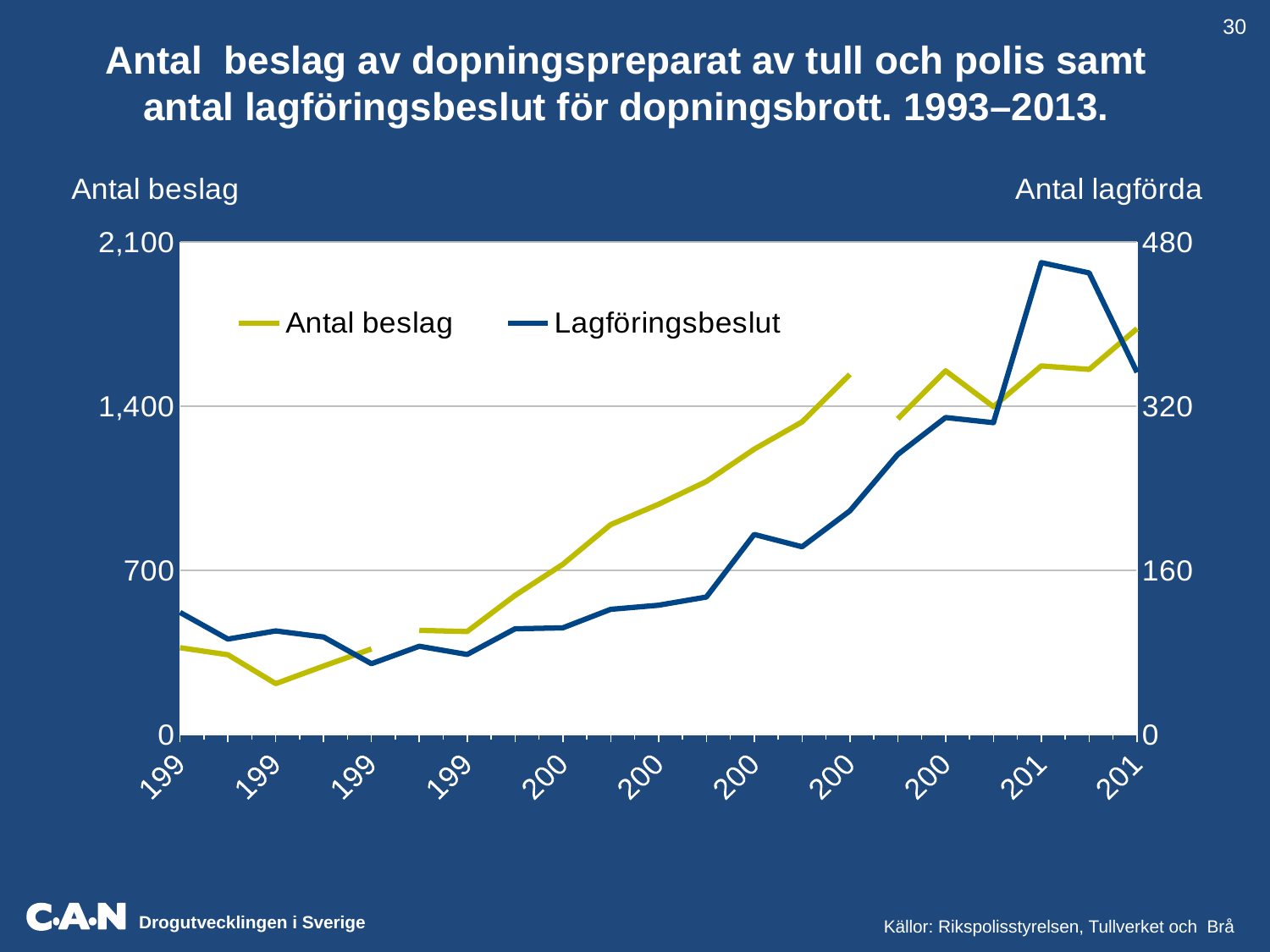
Does the Antal beslag series reach its highest value at the last point on the right of the chart? Yes What is the title of the right-hand vertical axis? Antal lagförda Is the highest value of the Lagföringsbeslut series greater or less than 320 on the right axis? greater What are the two series named in the legend? Antal beslag and Lagföringsbeslut Is the value of the Antal beslag series at the first point on the left greater or less than 700 on the left axis? less Is the lowest value of the Antal beslag series found near the left end or the right end of the chart? Left end What kind of chart is shown on the slide? Line chart Is the value of the Lagföringsbeslut series at the first point on the left greater or less than 160 on the right axis? less Overall, does the Lagföringsbeslut series rise or fall from left to right across the chart? rise Overall, does the Antal beslag series rise or fall from left to right across the chart? rise How many series does the legend list? 2